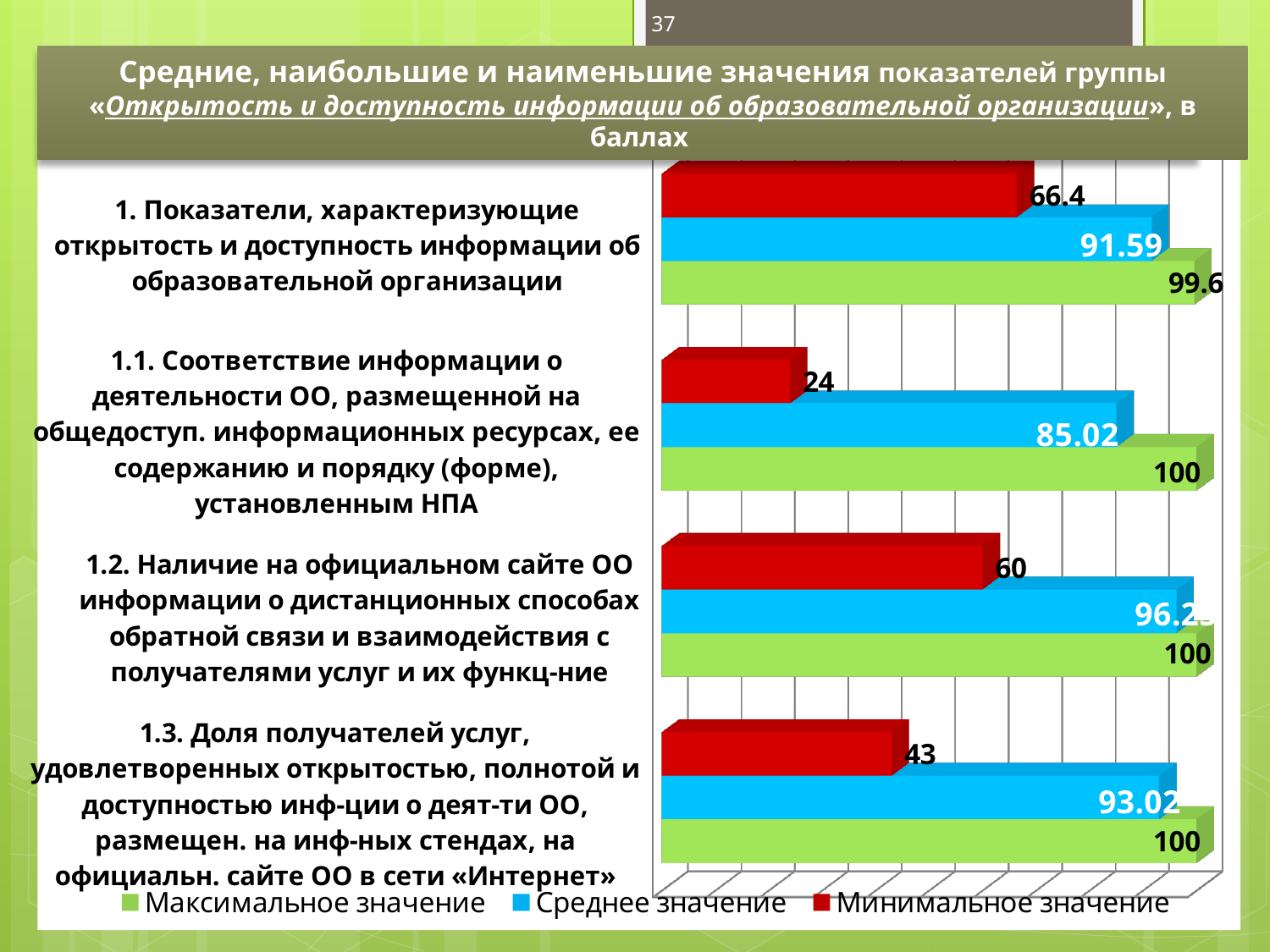
What is the average value (Среднее значение) for indicator 1.3 (Доля получателей услуг, удовлетворенных открытостью...)? 93.02 What is the minimum value (Минимальное значение) for indicator 1.2 (Наличие на официальном сайте ОО информации о дистанционных способах обратной связи...)? 60 How many series does the legend list? 3 What is the average value (Среднее значение) for indicator 1 (Показатели, характеризующие открытость и доступность информации об образовательной организации)? 91.59 What type of chart is shown on the slide? bar chart What is the difference between the maximum and minimum values for indicator 1.3? 57 What is the maximum value (Максимальное значение) for indicator 1? 99.6 Which indicator has the highest minimum value (Минимальное значение)? 1. Показатели, характеризующие открытость и доступность информации об образовательной организации Which indicator has the lowest minimum value (Минимальное значение)? 1.1. Соответствие информации о деятельности ОО, размещенной на общедоступ. информационных ресурсах... Is the minimum value for indicator 1.3 larger or smaller than the minimum value for indicator 1.2? smaller How many indicator categories are shown in the chart? 4 What is the minimum value (Минимальное значение) for indicator 1.1 (Соответствие информации о деятельности ОО...)? 24